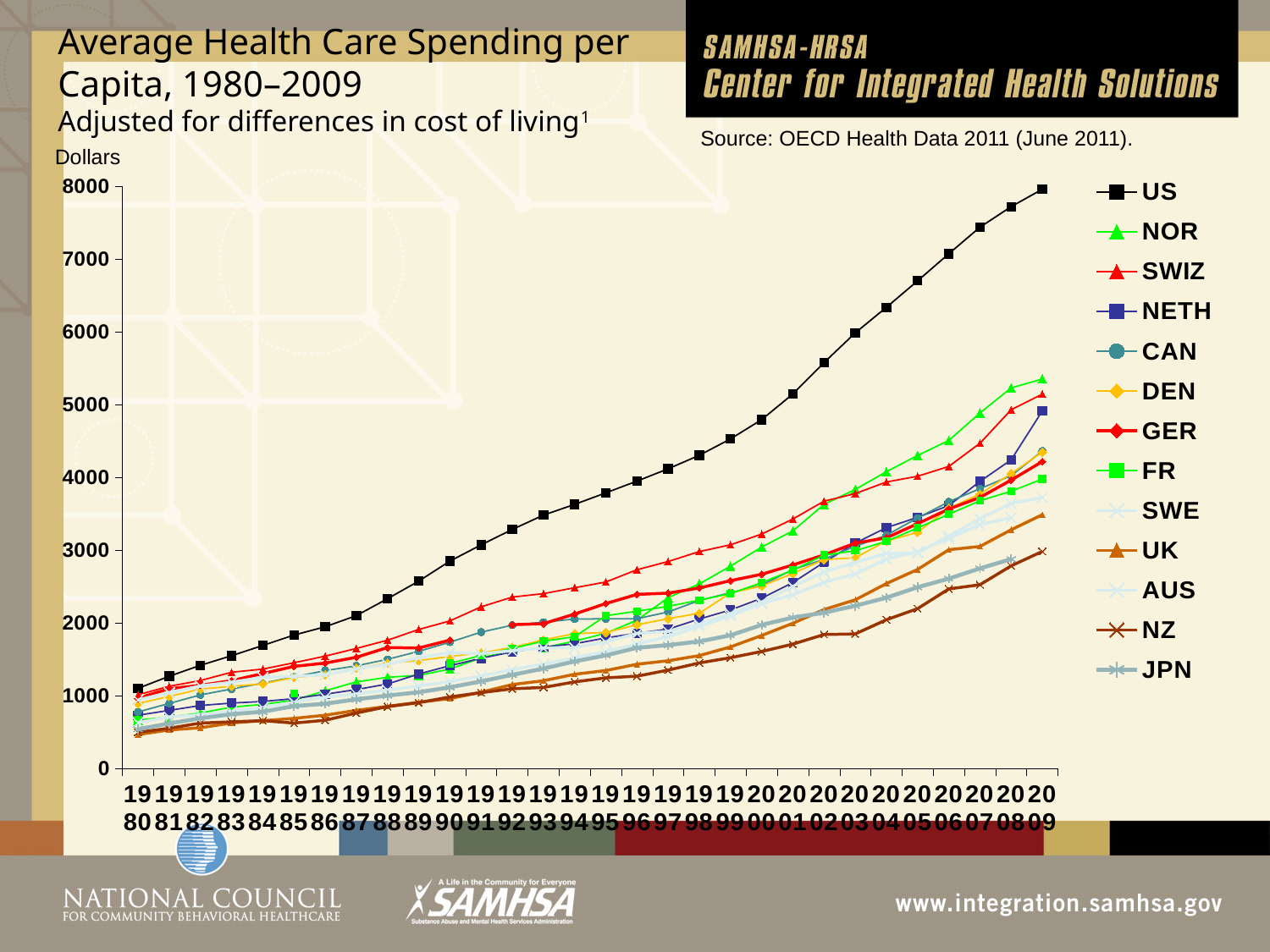
Is the value for NOR in 2009 greater or less than 5000? greater How many series does the legend list? 13 Is the value for the US in 1990 greater or less than 3000? less Is the value for the US in 2009 greater or less than 7000? greater How many years are plotted along the x axis? 30 What is the source cited for the chart data? OECD Health Data 2011 (June 2011) Which country has the highest health care spending per capita in 2009? US Does the US line rise or fall from 1980 to 2009? rise What kind of chart is shown on the slide? line chart What unit is shown as the label of the y axis? Dollars Which is larger in 2009, the value for GER or the value for the UK? GER